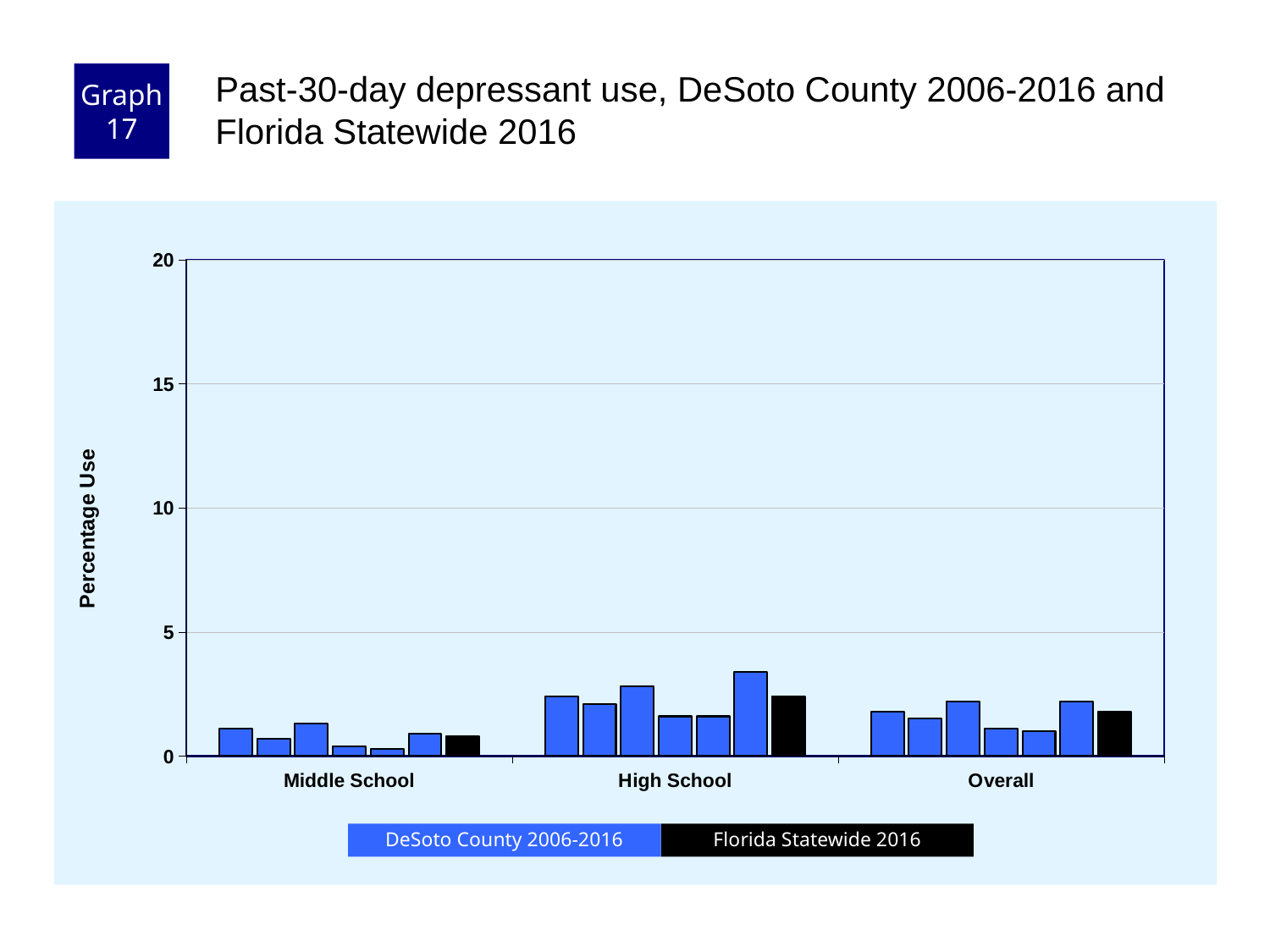
How many series does the legend list? 2 Is the tallest DeSoto County bar in the High School group greater or less than 5? less What kind of chart is shown on the slide? bar chart Is the Florida Statewide 2016 value for Middle School greater or less than 5? less Which category has the highest Florida Statewide 2016 value? High School How many categories are shown along the x axis? 3 Which is larger, the Florida Statewide 2016 value for Overall or for Middle School? Overall Which is larger, the Florida Statewide 2016 value for High School or for Middle School? High School Which category has the lowest Florida Statewide 2016 value? Middle School Is the Florida Statewide 2016 value for High School greater or less than 5? less What are the two series listed in the legend? DeSoto County 2006-2016 and Florida Statewide 2016 What is the label on the y axis? Percentage Use